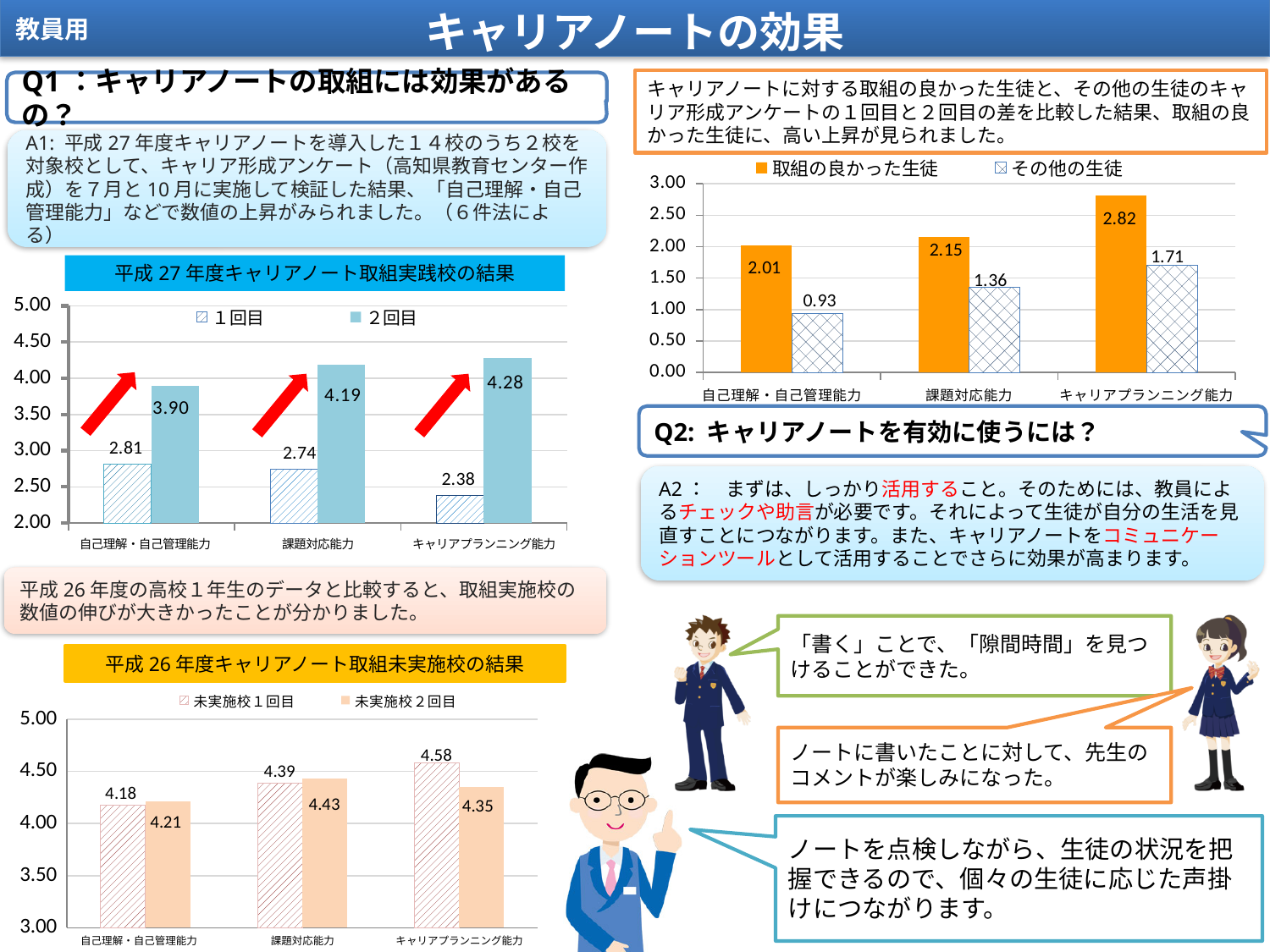
「平成26年度キャリアノート取組未実施校の結果」のグラフで、未実施校1回目の値が最も高い項目はどれですか？ キャリアプランニング能力 「平成27年度キャリアノート取組実践校の結果」のグラフで、1回目の値が最も低い項目はどれですか？ キャリアプランニング能力 「平成27年度キャリアノート取組実践校の結果」のグラフで、自己理解・自己管理能力の1回目と2回目の差はいくつですか？ 1.09 右上のグラフで、課題対応能力の「取組の良かった生徒」と「その他の生徒」の差はいくつですか？ 0.79 右上のグラフには、いくつの項目（カテゴリ）がありますか？ 3 「平成27年度キャリアノート取組実践校の結果」のグラフで、キャリアプランニング能力の2回目の値はいくつですか？ 4.28 「平成26年度キャリアノート取組未実施校の結果」のグラフで、課題対応能力の未実施校2回目の値はいくつですか？ 4.43 「平成26年度キャリアノート取組未実施校の結果」のグラフは、どの種類のグラフですか？ 棒グラフ 「平成27年度キャリアノート取組実践校の結果」のグラフの凡例には、いくつの系列がありますか？ 2 右上のグラフで、「その他の生徒」の値が最も低い項目はどれですか？ 自己理解・自己管理能力 「平成26年度キャリアノート取組未実施校の結果」のグラフで、キャリアプランニング能力は未実施校1回目と未実施校2回目のどちらが大きいですか？ 未実施校1回目 右上のグラフで、キャリアプランニング能力の「取組の良かった生徒」の値はいくつですか？ 2.82